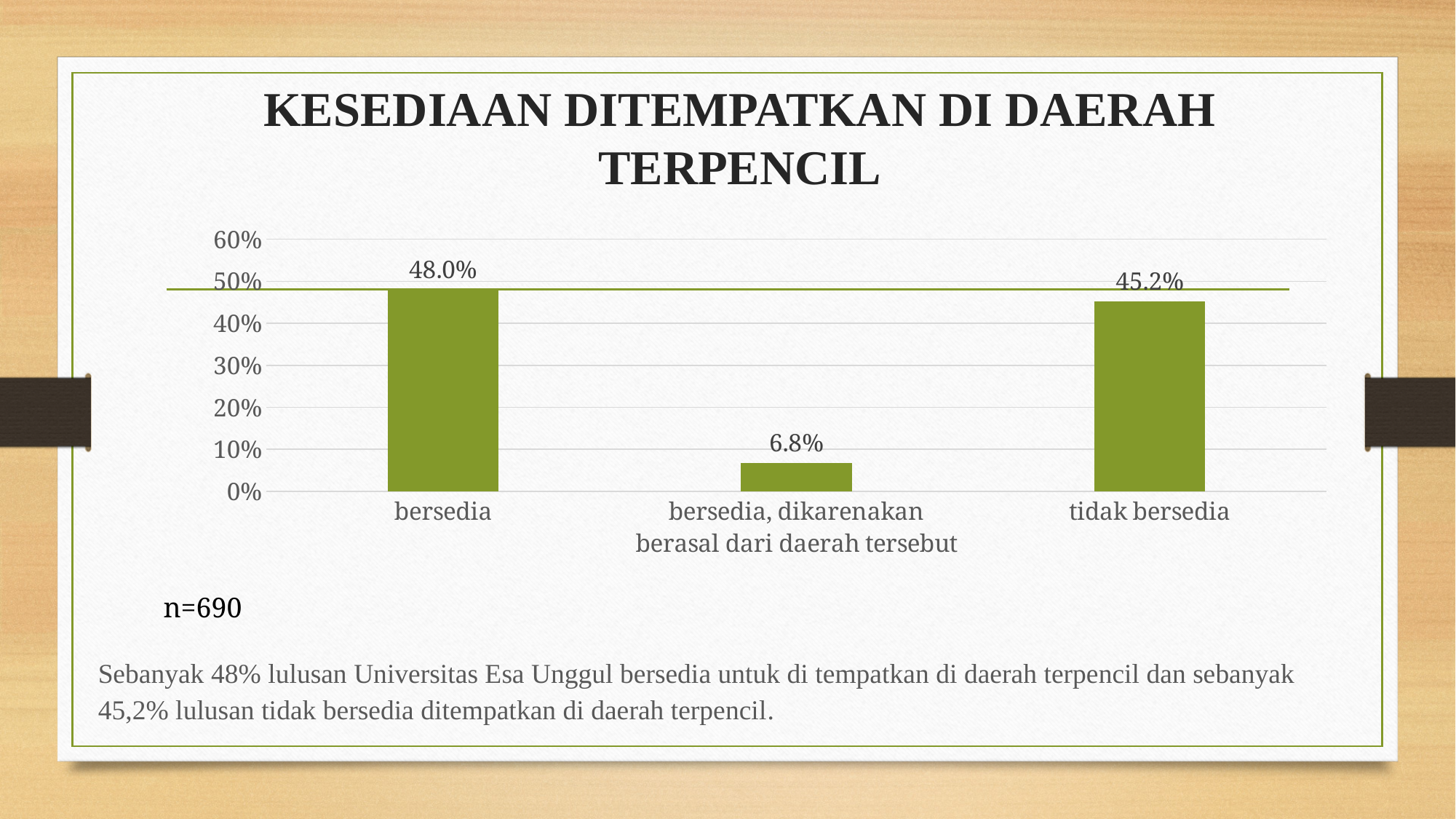
Which category has the lowest value? bersedia, dikarenakan berasal dari daerah tersebut How many categories are shown on the chart? 3 What is the difference between the values for "bersedia" and "tidak bersedia"? 2.8% Which category has the highest value? bersedia What is the title of the chart on the slide? KESEDIAAN DITEMPATKAN DI DAERAH TERPENCIL What kind of chart is shown on the slide? bar chart What is the value for "tidak bersedia"? 45.2% What is the value for "bersedia"? 48.0% Which is larger, the value for "bersedia" or the value for "bersedia, dikarenakan berasal dari daerah tersebut"? bersedia Is the value for "tidak bersedia" greater or less than 40%? greater What is the value for "bersedia, dikarenakan berasal dari daerah tersebut"? 6.8% What is the difference between the values for "tidak bersedia" and "bersedia, dikarenakan berasal dari daerah tersebut"? 38.4%